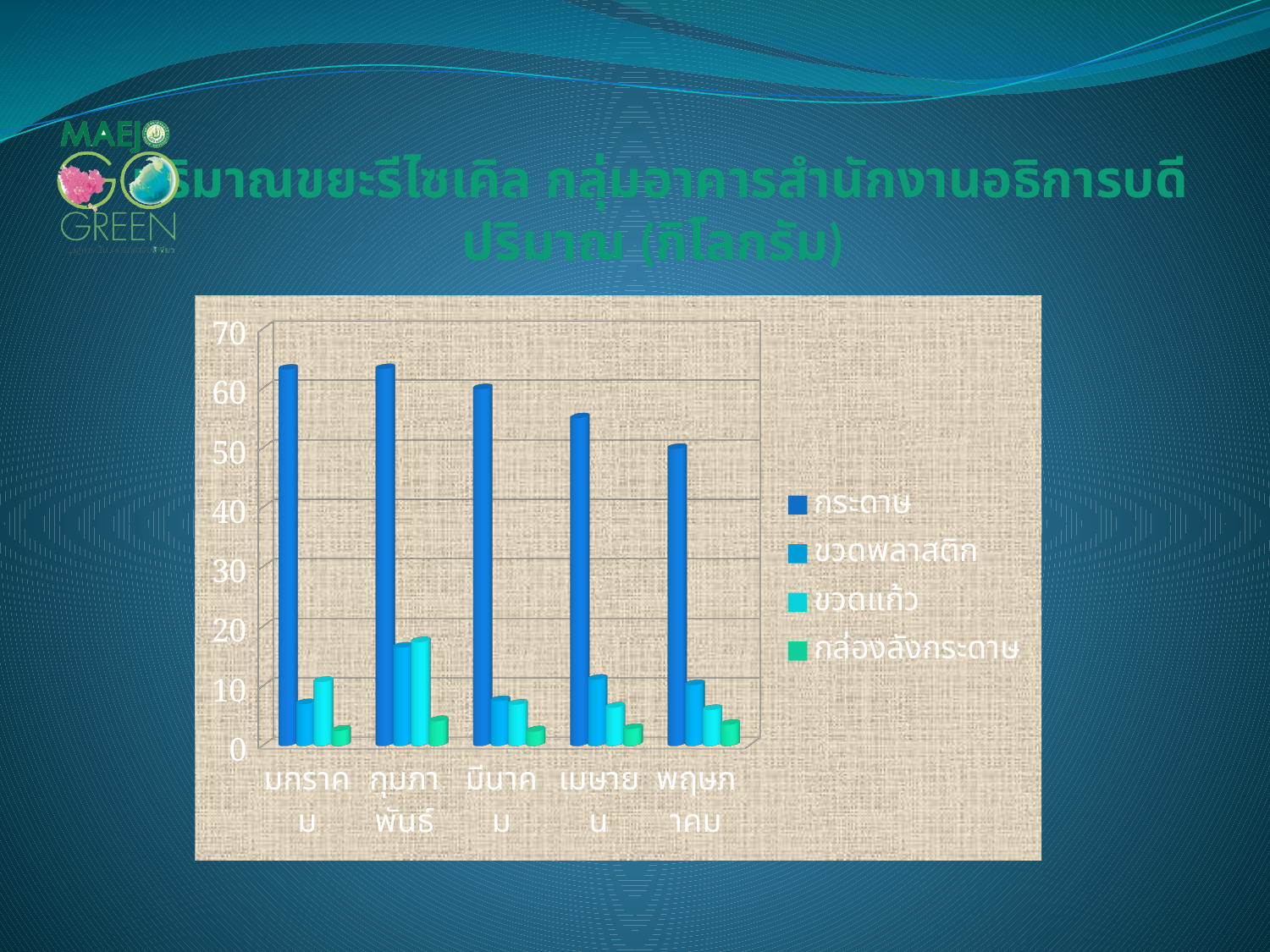
In which month is the value for ขวดแก้ว the highest? กุมภาพันธ์ How many series does the legend list? 4 How many months (categories) are shown along the x axis? 5 Do the values for กระดาษ generally rise or fall from มกราคม to พฤษภาคม? fall Which series is shown in dark blue according to the legend? กระดาษ Is the value for กระดาษ in พฤษภาคม greater or less than 60? less Is the value for ขวดแก้ว in มีนาคม greater or less than 10? less Which series is listed last in the legend? กล่องลังกระดาษ In which month is the value for กระดาษ the lowest? พฤษภาคม What kind of chart is shown on the slide? bar chart Is the value for ขวดพลาสติก in กุมภาพันธ์ greater or less than 10? greater